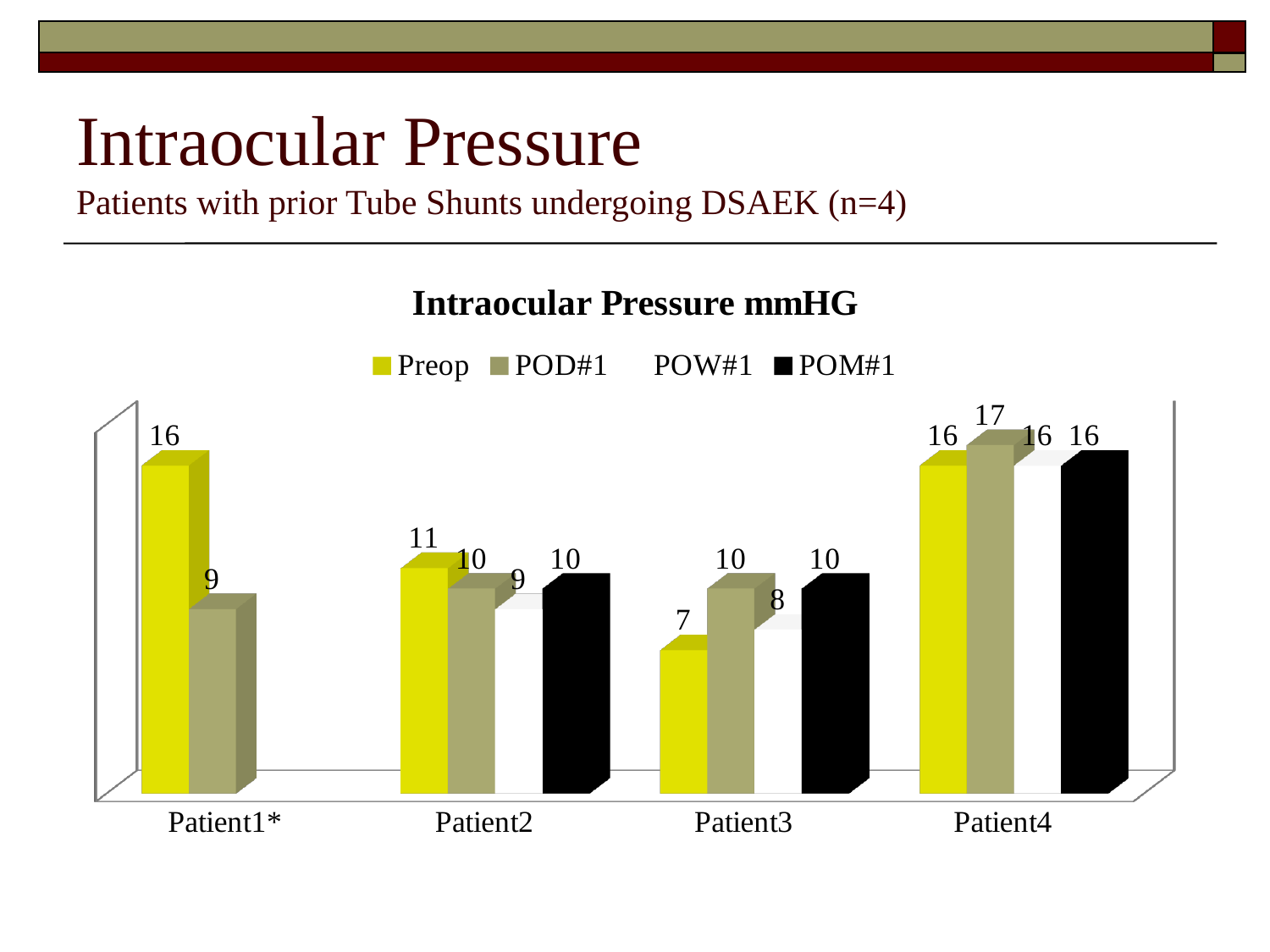
What is the POD#1 value for Patient4? 17 What is the difference between the Preop and POD#1 values for Patient1*? 7 Which patient has the highest POD#1 value? Patient4 What is the POD#1 value for Patient3? 10 Which is larger for Patient3, the Preop value or the POM#1 value? POM#1 What kind of chart is shown? Bar chart Which patient has the lowest Preop value? Patient3 What is the Preop value for Patient1*? 16 What is the POM#1 value for Patient2? 10 What is the title of the chart? Intraocular Pressure mmHG How many patients (categories) are shown on the x axis? 4 How many series does the legend list? 4